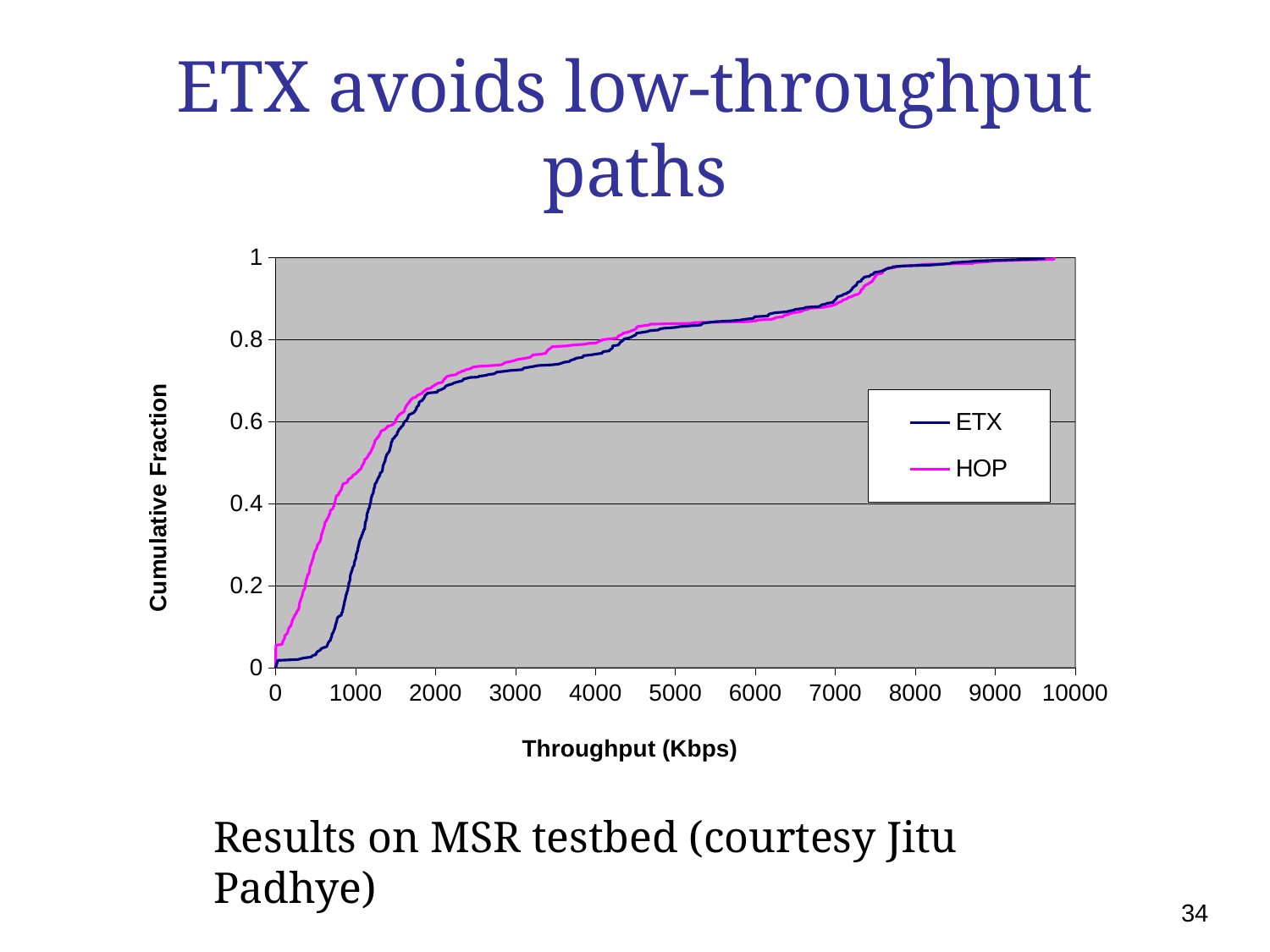
What kind of chart is shown on the slide? line chart What is the label of the x axis? Throughput (Kbps) What are the two series named in the legend? ETX and HOP How many series does the legend list? 2 Do the values of the ETX series rise or fall as throughput increases along the x axis? rise Is the cumulative fraction for ETX at 2000 Kbps greater or less than 0.6? greater Is the cumulative fraction for HOP at 1000 Kbps greater or less than 0.4? greater At a throughput of 1000 Kbps, which series has the higher cumulative fraction, ETX or HOP? HOP Is the cumulative fraction for ETX at 3000 Kbps greater or less than 0.8? less At a throughput of 500 Kbps, which series has the higher cumulative fraction, ETX or HOP? HOP